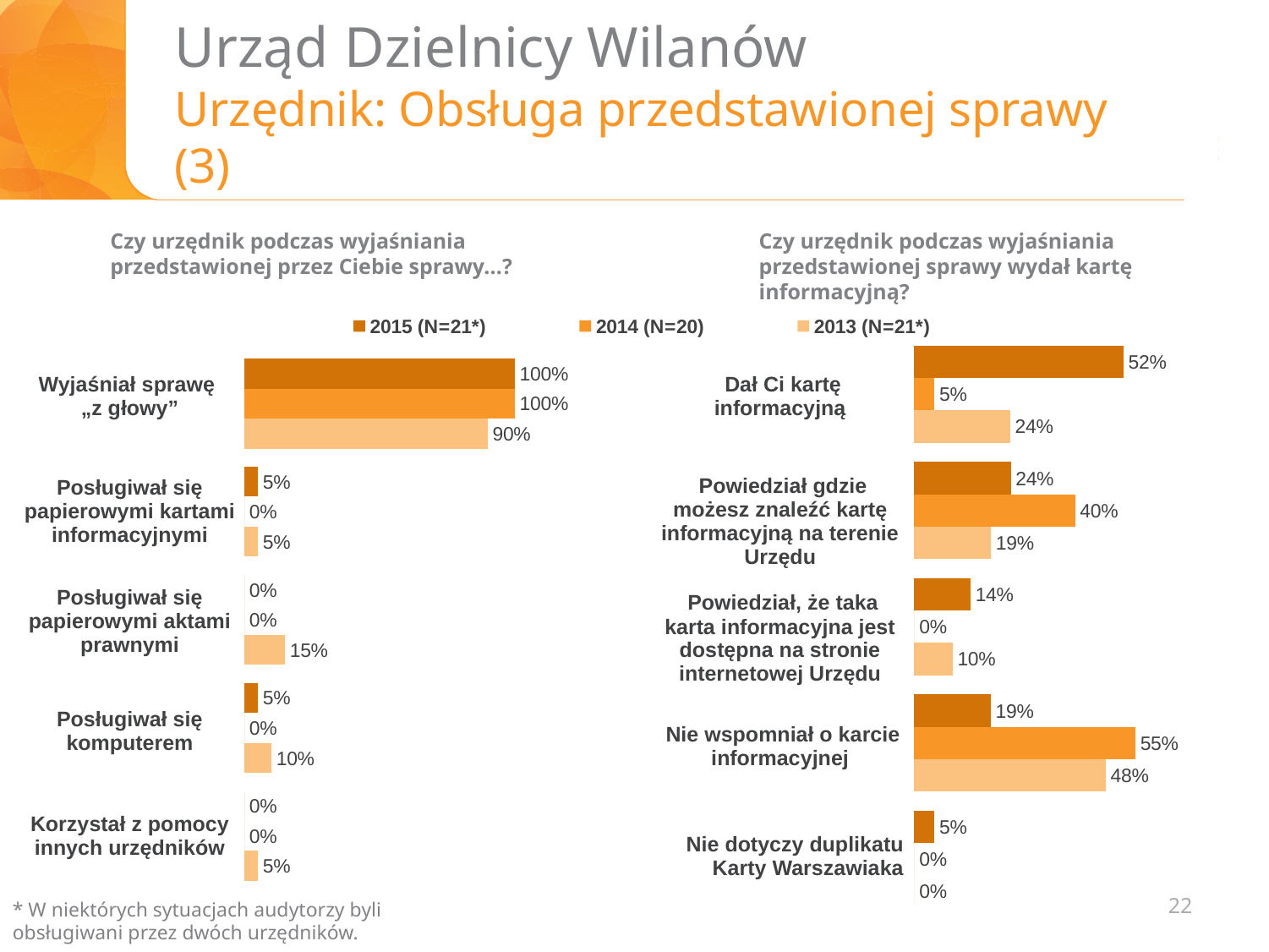
In the right chart, what is the 2014 (N=20) value for "Nie wspomniał o karcie informacyjnej"? 55% In the left chart, which category has the highest 2015 (N=21*) value? Wyjaśniał sprawę „z głowy” How many categories does the left chart show? 5 In the right chart, which category has the highest 2014 (N=20) value? Nie wspomniał o karcie informacyjnej In the left chart, what is the 2013 (N=21*) value for "Posługiwał się papierowymi aktami prawnymi"? 15% How many series does the legend list? 3 In the right chart, what is the difference between the 2015 (N=21*) and 2014 (N=20) values for "Dał Ci kartę informacyjną"? 47 percentage points What type of chart is the right chart? Bar chart In the left chart ("Czy urzędnik podczas wyjaśniania przedstawionej przez Ciebie sprawy...?"), what is the 2013 (N=21*) value for "Wyjaśniał sprawę „z głowy”"? 90% In the right chart, what is the 2013 (N=21*) value for "Nie wspomniał o karcie informacyjnej"? 48% In the right chart ("Czy urzędnik podczas wyjaśniania przedstawionej sprawy wydał kartę informacyjną?"), what is the 2015 (N=21*) value for "Dał Ci kartę informacyjną"? 52% In the right chart, for "Powiedział gdzie możesz znaleźć kartę informacyjną na terenie Urzędu", which year has the larger value: 2014 (N=20) or 2013 (N=21*)? 2014 (N=20)